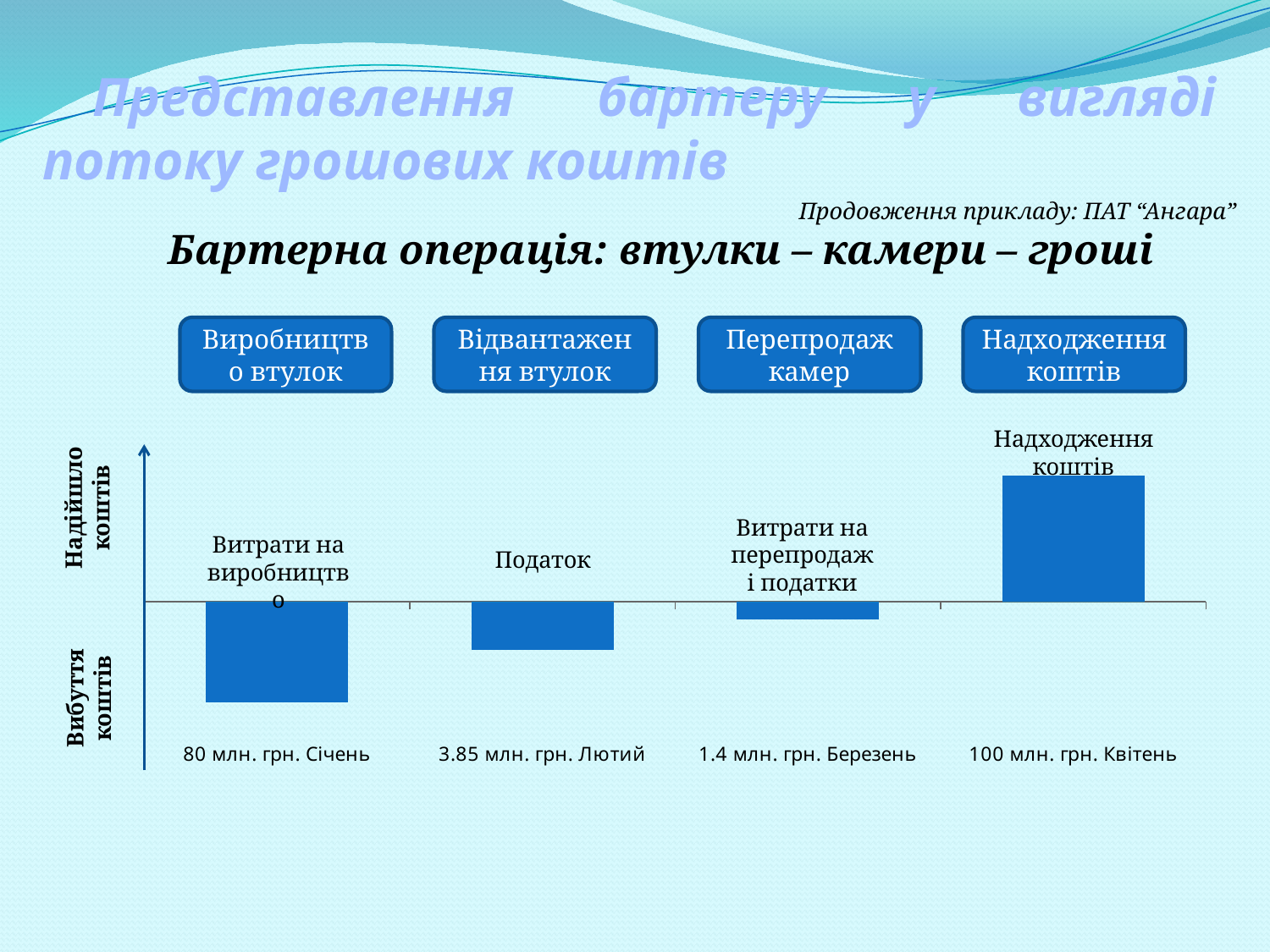
What kind of chart is shown on the slide? bar chart What amount is shown for Січень? 80 млн. грн. Which month has the largest bar in the chart? Квітень What amount is shown for Лютий? 3.85 млн. грн. Which month has the smallest bar in the chart? Березень What amount is shown for Березень? 1.4 млн. грн. What amount is shown for Квітень? 100 млн. грн. What label is written above the bar for Лютий? Податок Which is larger in amount, Лютий or Березень? Лютий Which month's bar is the only one drawn above the horizontal axis? Квітень What is the difference between the amounts for Квітень and Січень? 20 млн. грн. How many bars are plotted in the chart? 4